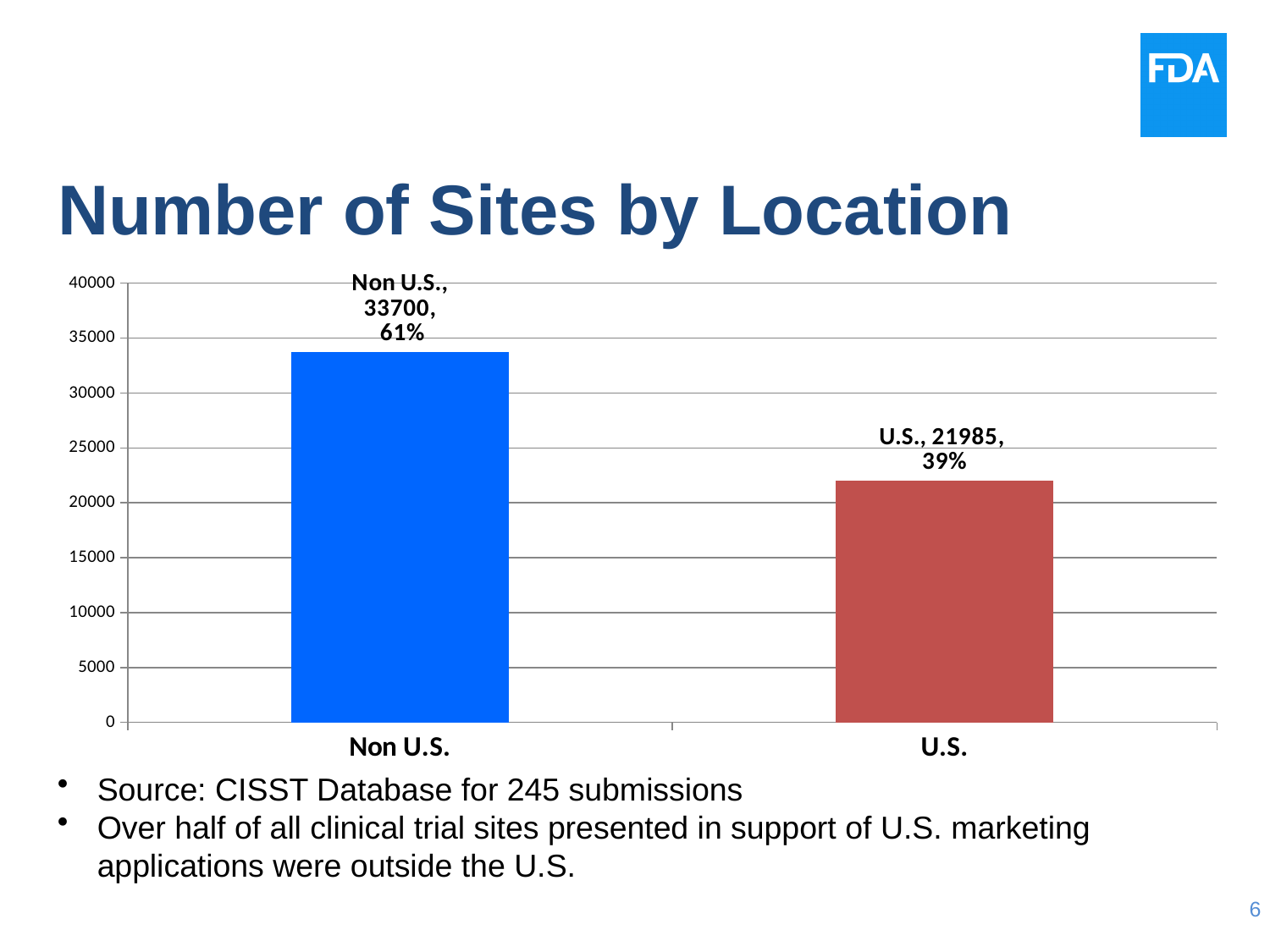
What is the number of sites for U.S.? 21985 What percentage share is shown for U.S. sites? 39% What kind of chart is shown on the slide? bar chart What percentage share is shown for Non U.S. sites? 61% What is the title of the chart? Number of Sites by Location Which location has the lower number of sites? U.S. What is the number of sites for Non U.S.? 33700 Which location has the higher number of sites? Non U.S. What is the difference between the number of Non U.S. sites and U.S. sites? 11715 Is the number of Non U.S. sites greater or less than 30000? greater How many categories are shown on the x axis? 2 Is the number of U.S. sites greater or less than 25000? less